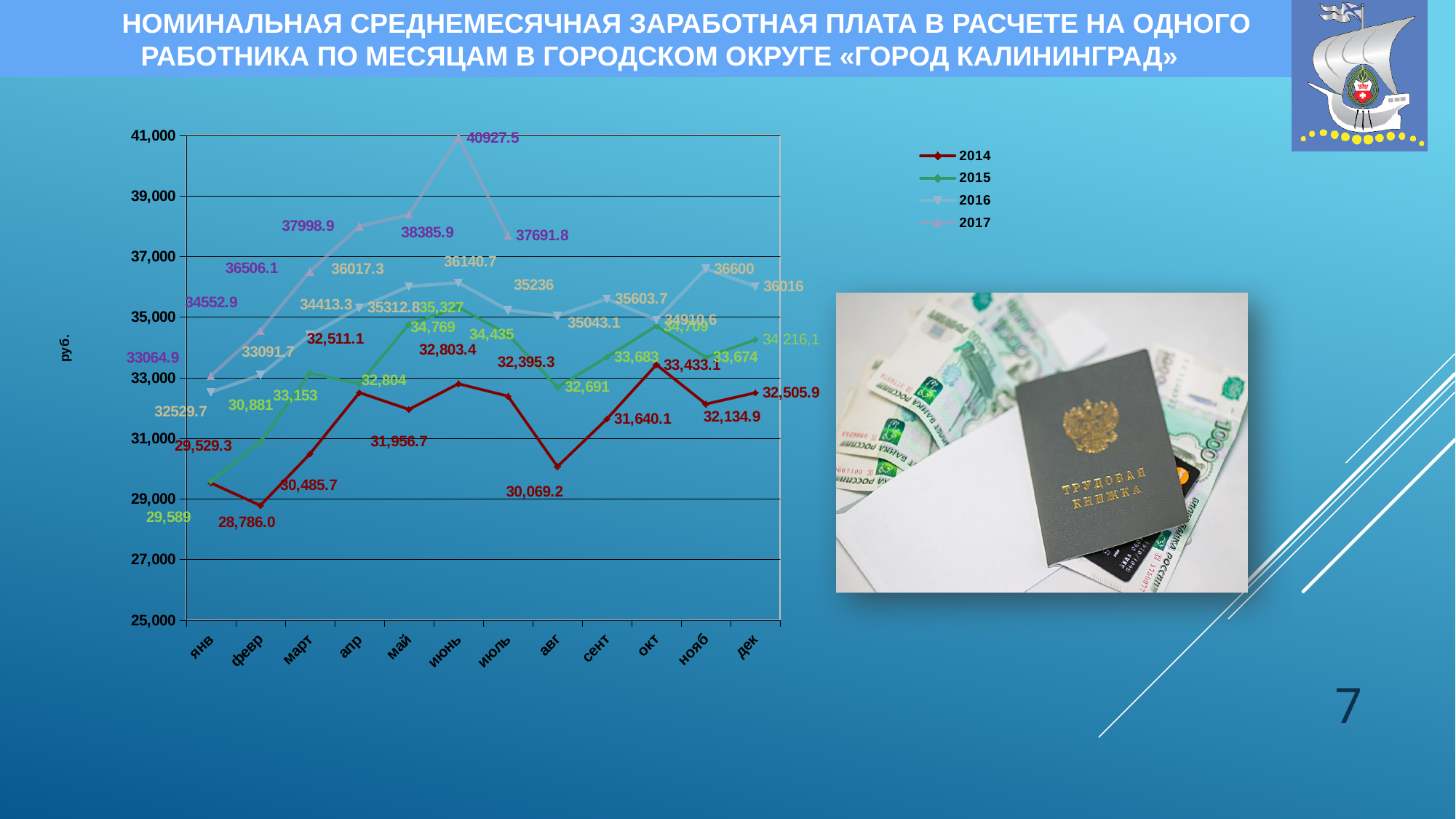
How many series does the legend list? 4 Which series and month has the highest value on the whole chart? 2017, июнь In the 2016 series, which is larger: the value for нояб or the value for дек? нояб What is the value for февр in the 2014 series? 28,786.0 How many months are shown along the x axis? 12 What is the value for июнь in the 2017 series? 40927.5 In which month does the 2014 series reach its lowest value? февр What kind of chart is shown on the slide? line chart What is the difference between the 2014 values for окт and февр? 4,647.1 Does the 2017 series rise or fall from янв to июнь? rise What label is shown on the vertical axis? руб. What is the value for нояб in the 2016 series? 36600